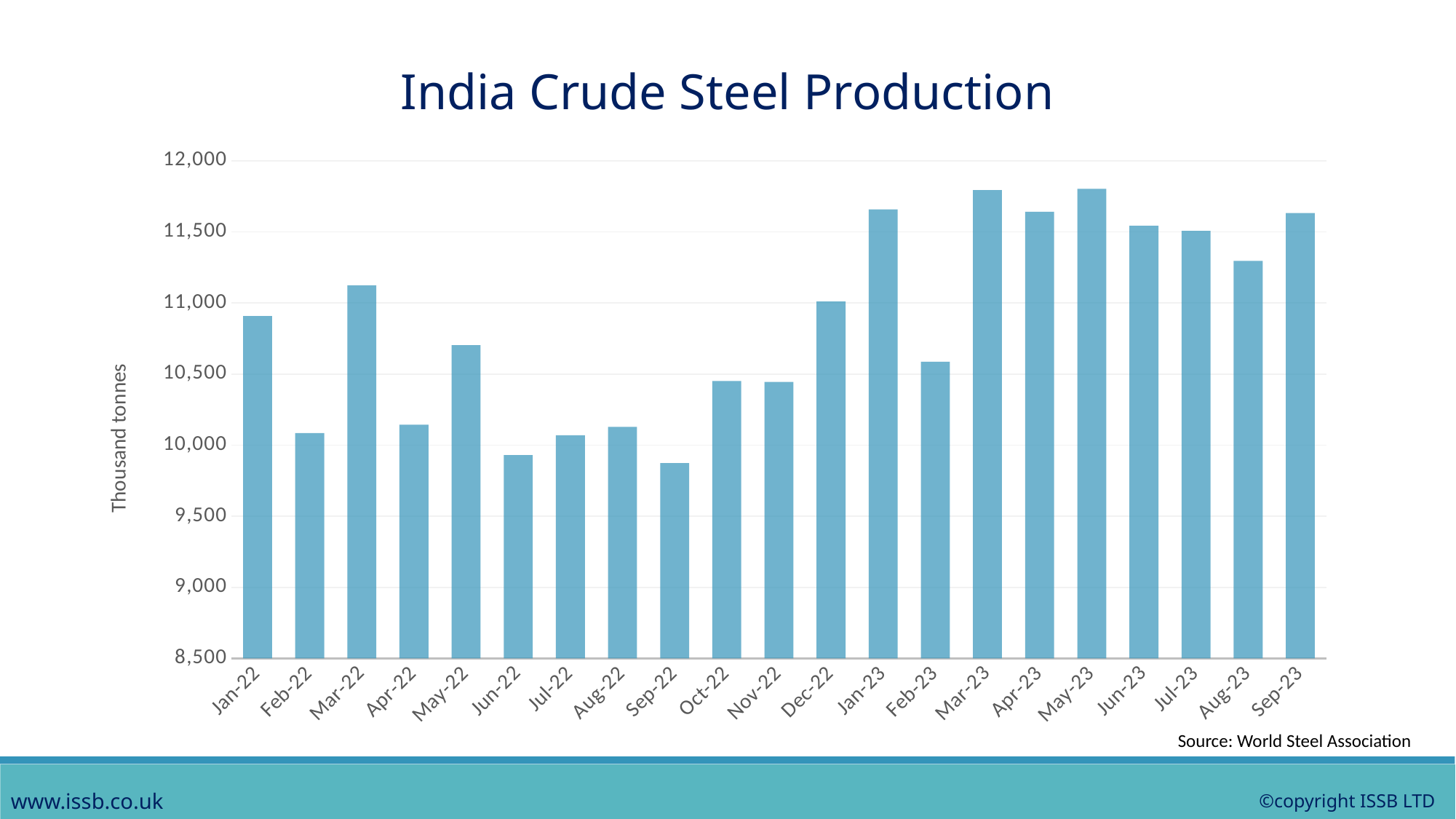
What unit is shown on the vertical axis label? Thousand tonnes Is the value for Mar-23 greater or less than 11,500? greater Is the value for Jan-22 greater or less than 10,500? greater What kind of chart is shown on the slide? bar chart Do the values rise or fall from May-23 to Aug-23? fall Which is larger, the value for Mar-22 or the value for Jan-22? Mar-22 Which month has the lowest crude steel production on the chart? Sep-22 Is the value for Feb-23 greater or less than 11,000? less How many months are plotted on the chart? 21 Which is larger, the value for Jan-23 or the value for Feb-23? Jan-23